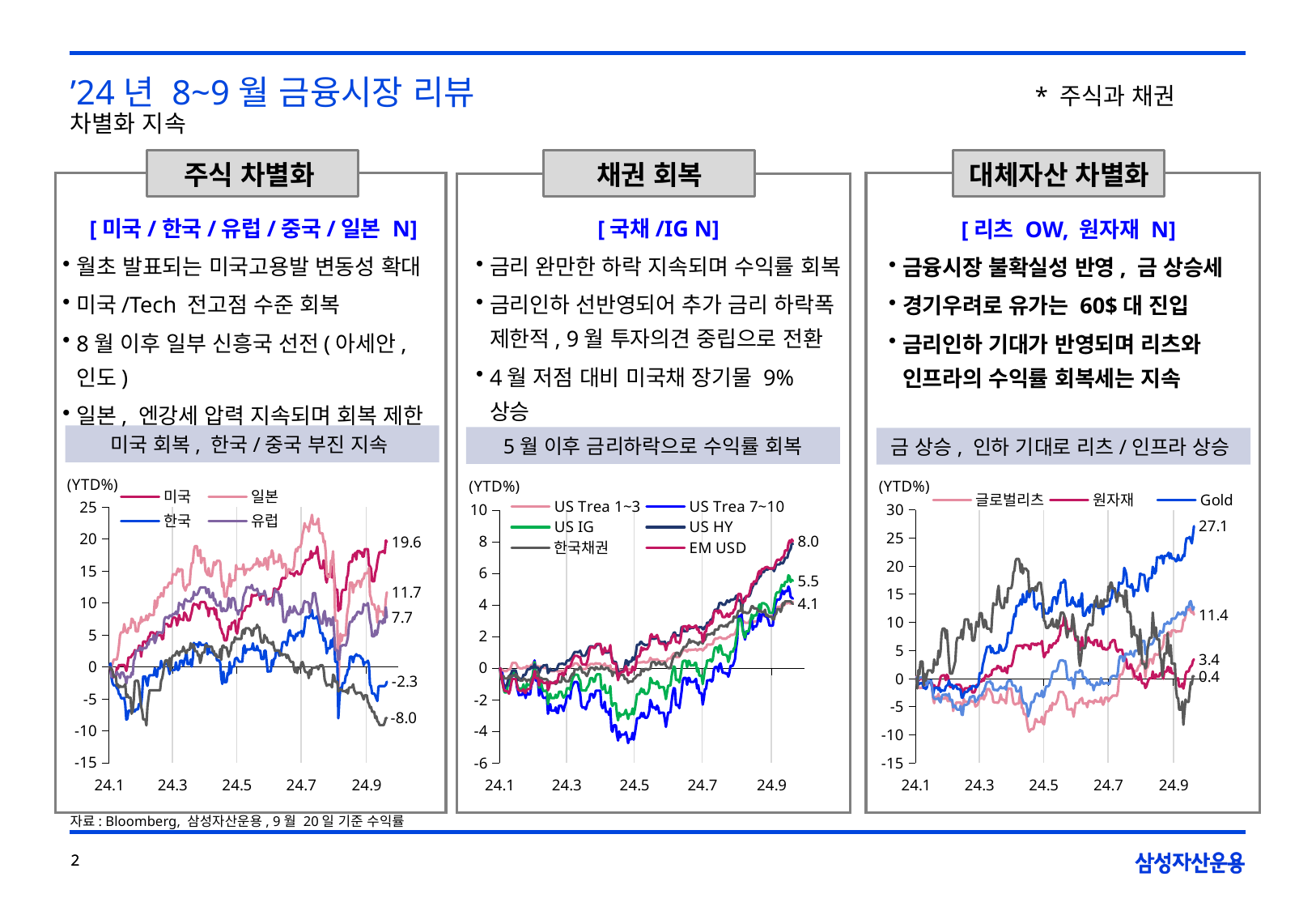
In the middle chart (채권 회복), how many series does the legend list? 6 In the left chart (주식 차별화), what is the difference between the end values labelled 19.6 and 11.7? 7.9 In the right chart (대체자산 차별화), how many series does the legend list? 3 In the right chart (대체자산 차별화), what is the end-of-period value labelled for Gold? 27.1 In the middle chart (채권 회복), what is the end-of-period value labelled for EM USD? 8.0 What kind of chart is shown under the '주식 차별화' heading on the left? line chart In the left chart (주식 차별화), which legend series has the highest value at the end of the period? 미국 In the left chart (주식 차별화), which is higher at the end of the period, 미국 or 한국? 미국 In the right chart (대체자산 차별화), which series has the highest value at the end of the period? Gold In the left chart (주식 차별화), what is the end-of-period value labelled for 미국? 19.6 In the left chart (주식 차별화), how many series does the legend list? 4 In the right chart (대체자산 차별화), is the end value for Gold greater or less than 20? greater